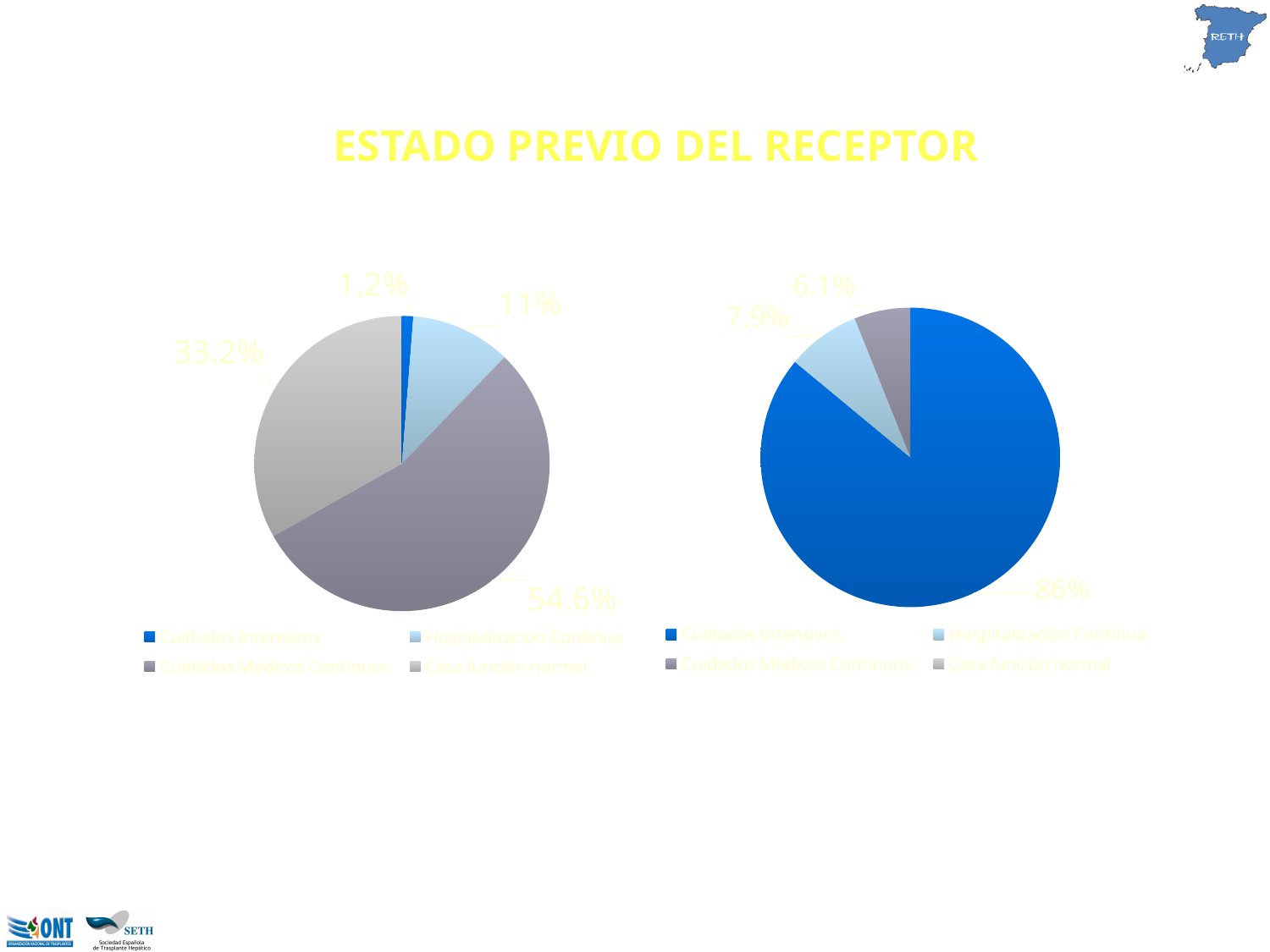
In the right pie chart, what share is labelled for Hospitalización Continua? 7.9% In the left pie chart, what share is labelled for Cuidados Intensivos? 1.2% In the left pie chart, what share is labelled for Casa función normal? 33.2% What type of chart is used on this slide? Pie chart In the right pie chart, which category has the largest slice? Cuidados Intensivos In the left pie chart, which category has the smallest slice? Cuidados Intensivos In the left pie chart, what share is labelled for Cuidados Médicos Continuos? 54.6% In the right pie chart, what share is labelled for Cuidados Intensivos? 86% In the right pie chart, what share is labelled for Cuidados Médicos Continuos? 6.1% In the left pie chart, which category has the largest slice? Cuidados Médicos Continuos In the right pie chart, which is larger, the share for Hospitalización Continua or the share for Cuidados Médicos Continuos? Hospitalización Continua In the left pie chart, what is the difference between the shares for Cuidados Médicos Continuos and Casa función normal? 21.4%